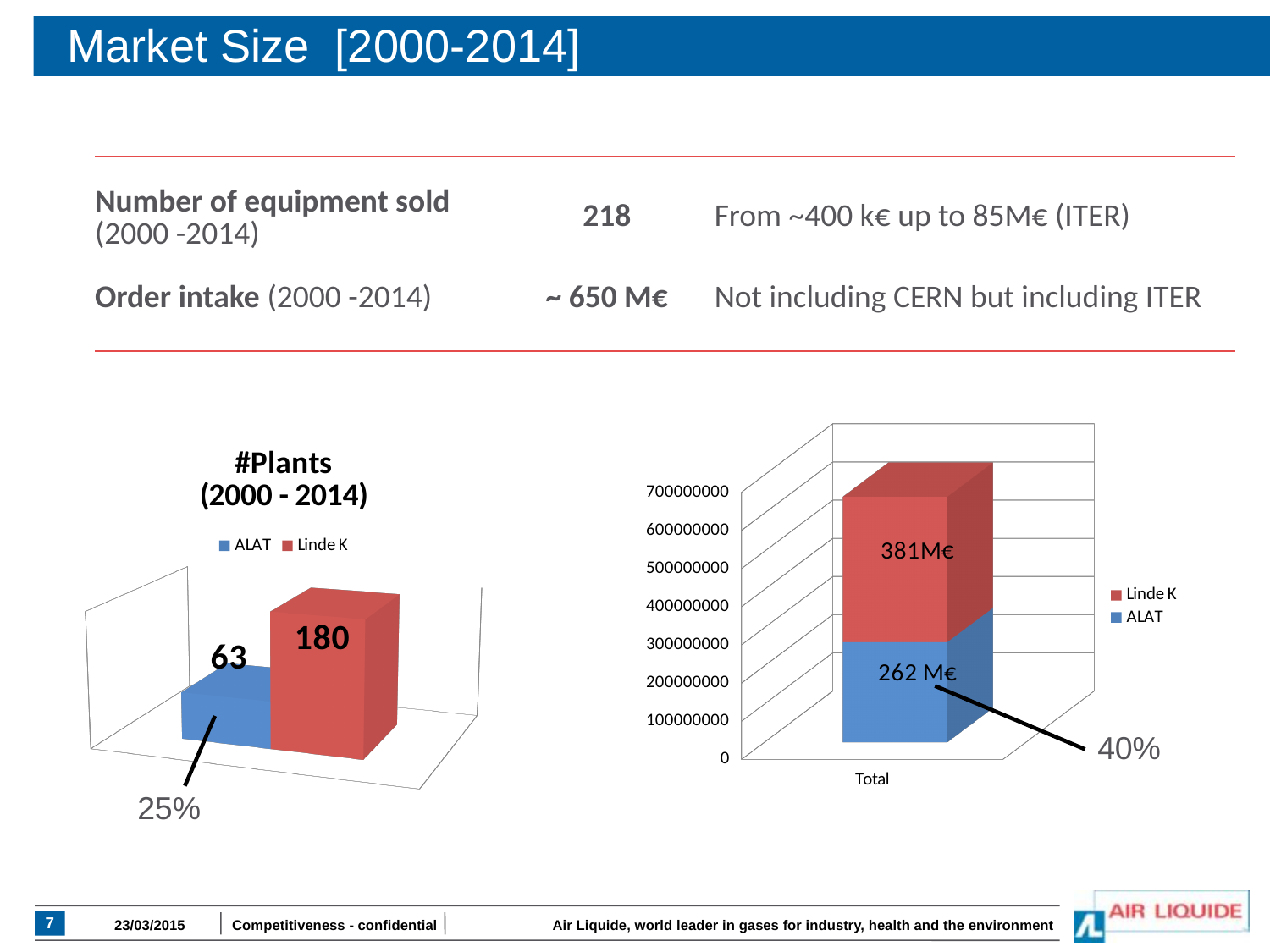
In the chart on the right of the slide, what is the value labelled for Linde K? 381M€ In the chart on the right of the slide, what is the value labelled for ALAT? 262 M€ What kind of chart is the #Plants (2000 - 2014) chart? Bar chart In the chart on the right of the slide, is the top of the stacked bar greater or less than 600000000? greater In the #Plants (2000 - 2014) chart, what is the value for ALAT? 63 In the #Plants (2000 - 2014) chart, how many series does the legend list? 2 In the #Plants (2000 - 2014) chart, what is the difference between the Linde K and ALAT values? 117 In the chart on the right of the slide, what is the category label on the x axis? Total In the #Plants (2000 - 2014) chart, what is the value for Linde K? 180 In the #Plants (2000 - 2014) chart, which series has the higher number of plants? Linde K In the chart on the right of the slide, which series is shown in blue? ALAT In the chart on the right of the slide, which series has the larger value, Linde K or ALAT? Linde K